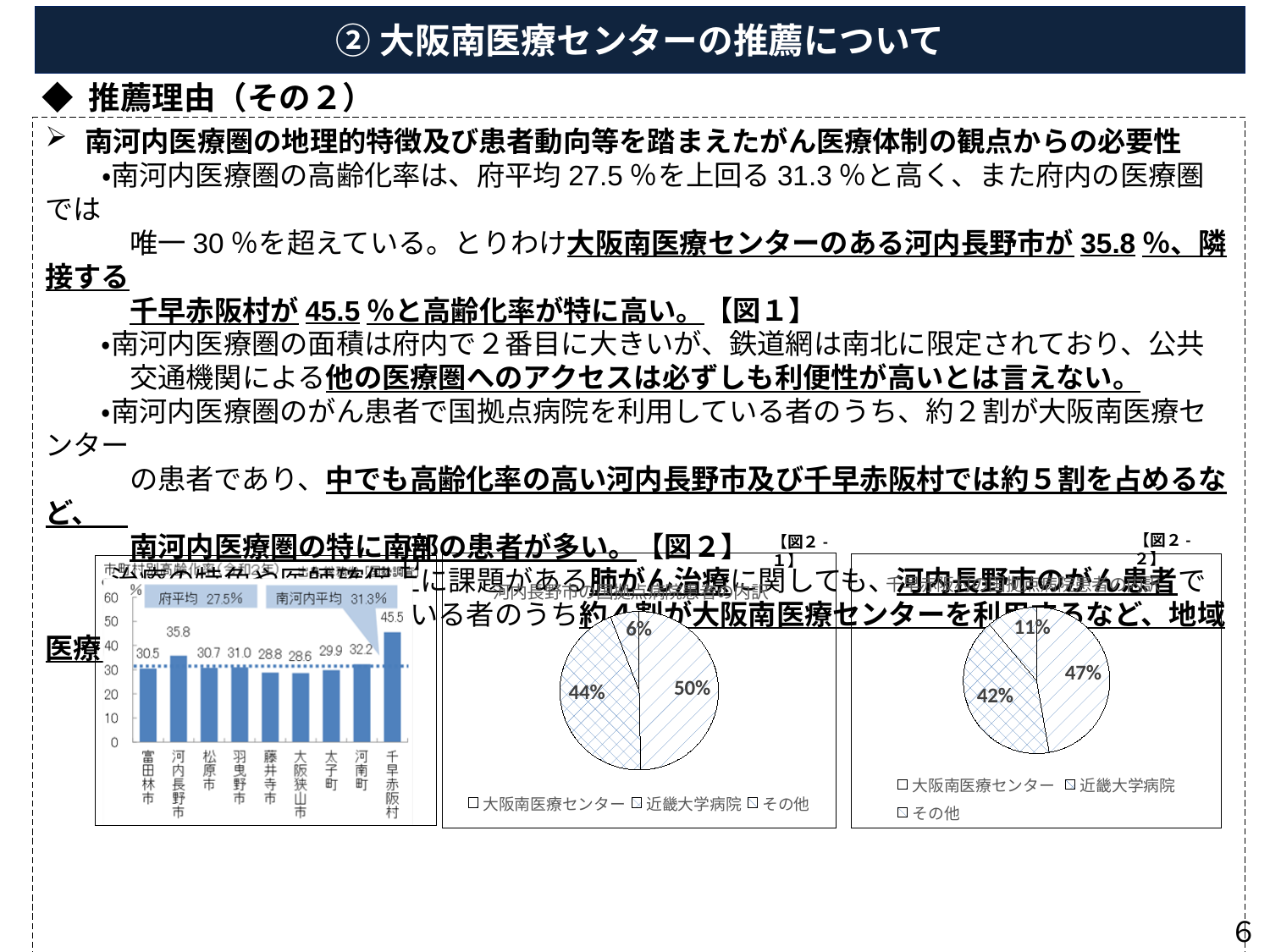
In the bar chart at the bottom left (図1), what is the value for 千早赤阪村? 45.5 In the bar chart at the bottom left (図1), how many municipalities are shown on the x axis? 9 In the pie chart labelled 【図2-2】 (right), what is the smallest slice's share? 11% In the pie chart labelled 【図2-1】 (middle), what is the largest slice's share? 50% In the bar chart at the bottom left (図1), what is the difference between the values for 千早赤阪村 and 河内長野市? 9.7 In the bar chart at the bottom left (図1), which municipality has the lowest value? 大阪狭山市 What kind of chart is 図1 at the bottom left of the slide? bar chart In the bar chart at the bottom left (図1), which municipality has the highest value? 千早赤阪村 In the bar chart at the bottom left (図1), what value is shown for 府平均? 27.5% In the bar chart at the bottom left (図1), what is the value for 河内長野市? 35.8 In the bar chart at the bottom left (図1), which is larger, the value for 河南町 or the value for 羽曳野市? 河南町 How many entries does the legend of the pie chart labelled 【図2-2】 (right) list? 3